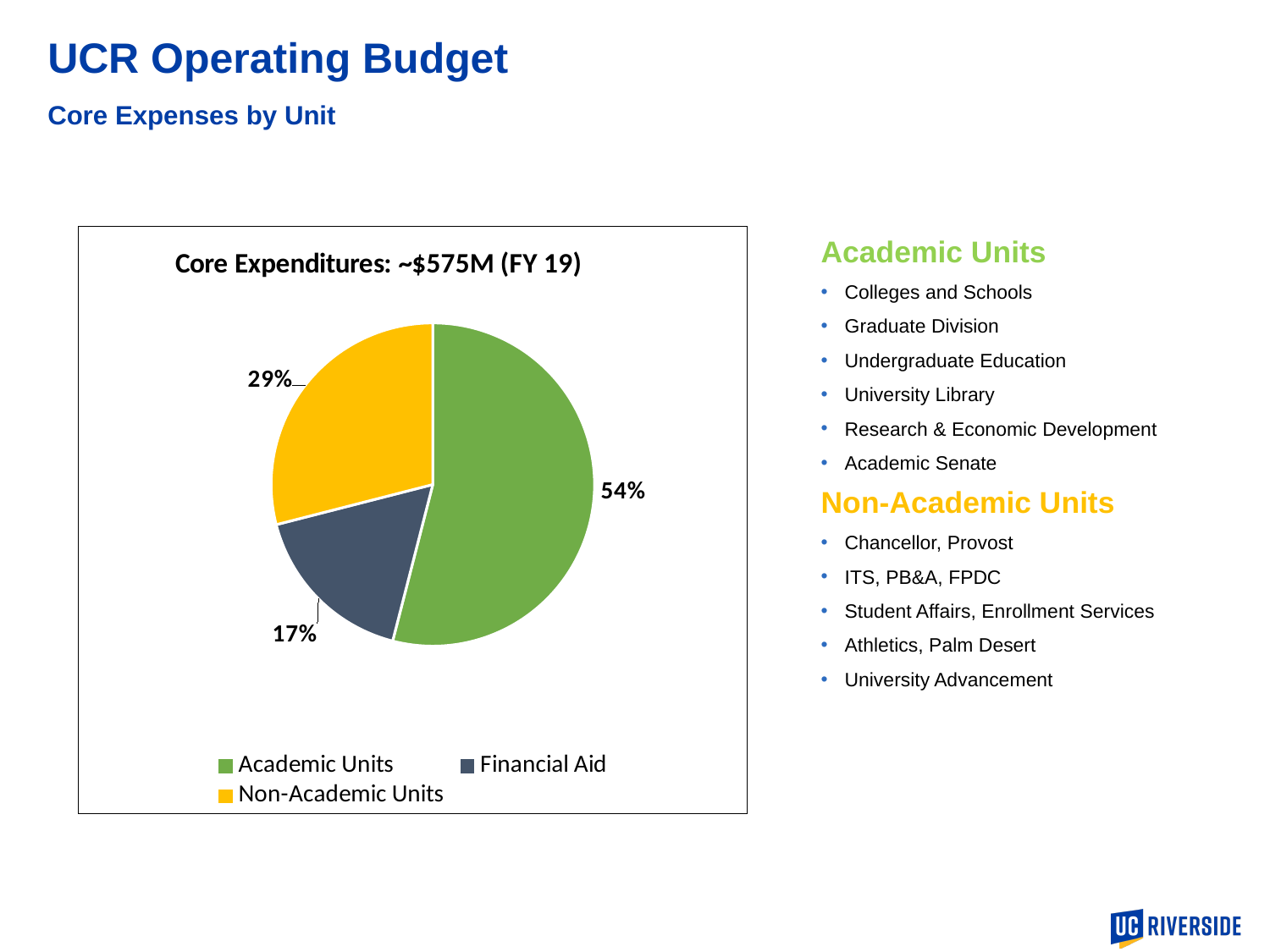
What is the difference in percentage points between the Non-Academic Units and Financial Aid slices? 12 How many slices does the pie chart have? 3 What share of core expenditures goes to Academic Units? 54% Which colour represents Financial Aid in the chart? Dark blue-grey Which category has the smallest slice of the pie? Financial Aid Which is larger, the Non-Academic Units slice or the Financial Aid slice? Non-Academic Units What is the title of the chart? Core Expenditures: ~$575M (FY 19) What kind of chart is shown on the slide? Pie chart What share of core expenditures goes to Financial Aid? 17% What is the difference in percentage points between the Academic Units and Non-Academic Units slices? 25 What share of core expenditures goes to Non-Academic Units? 29% Which category has the largest slice of the pie? Academic Units